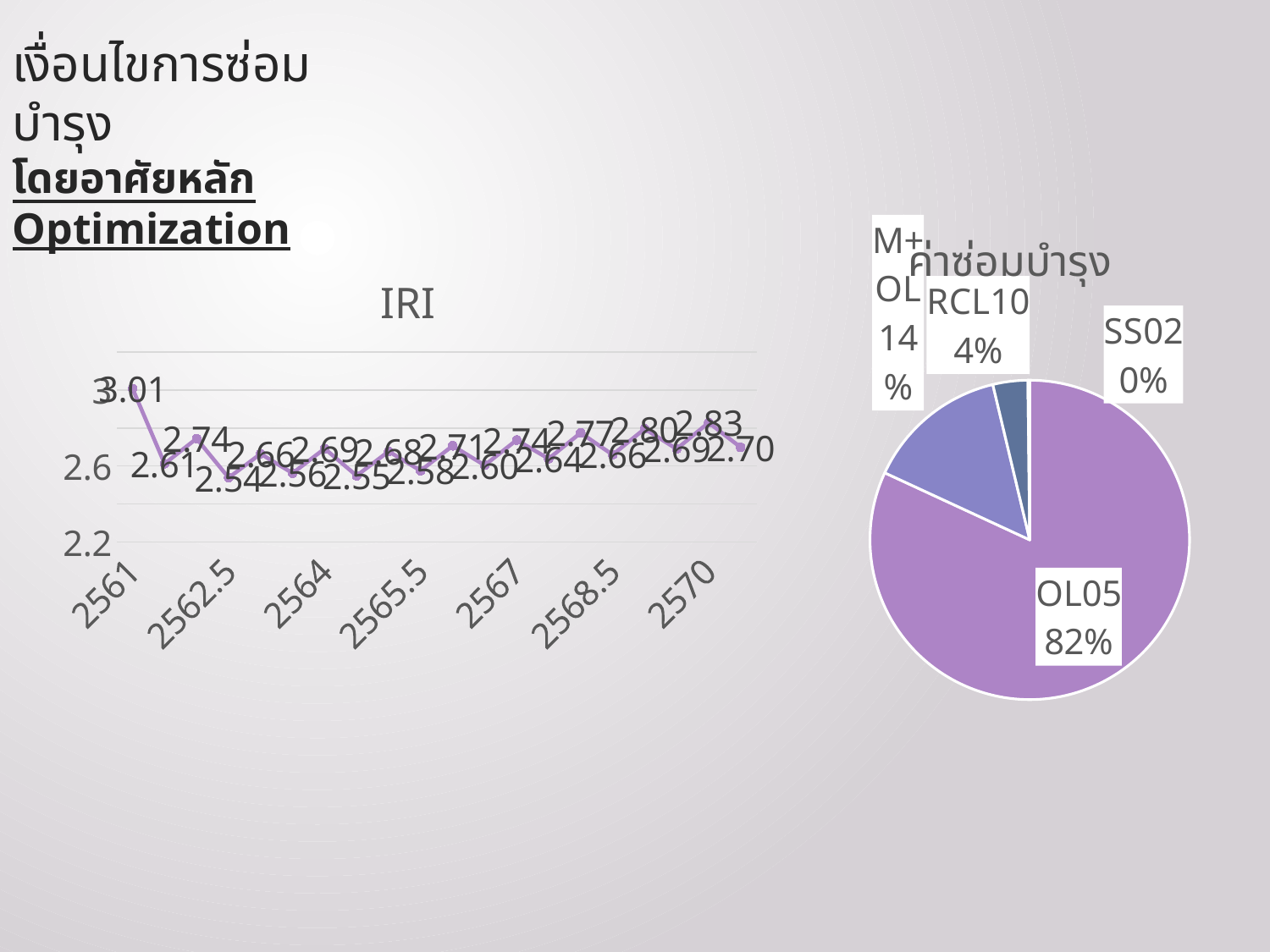
In the pie chart "ค่าซ่อมบำรุง", how many percentage points larger is OL05's share than M+OL's share? 68 In the pie chart "ค่าซ่อมบำรุง", which category has the smallest share? SS02 What kind of chart is the chart titled "IRI"? line chart In the line chart "IRI", is the value at 2561 greater or less than 2.6? greater In the pie chart "ค่าซ่อมบำรุง", what share does RCL10 have? 4% How many slices are labelled in the pie chart "ค่าซ่อมบำรุง"? 4 What kind of chart is the chart titled "ค่าซ่อมบำรุง" on the right of the slide? pie chart In the line chart "IRI", what is the highest plotted value? 3.01 In the pie chart "ค่าซ่อมบำรุง", what share does OL05 have? 82% In the pie chart "ค่าซ่อมบำรุง", what share does M+OL have? 14% In the pie chart "ค่าซ่อมบำรุง", which category has the largest slice? OL05 In the pie chart "ค่าซ่อมบำรุง", which is larger, the share of OL05 or the share of RCL10? OL05